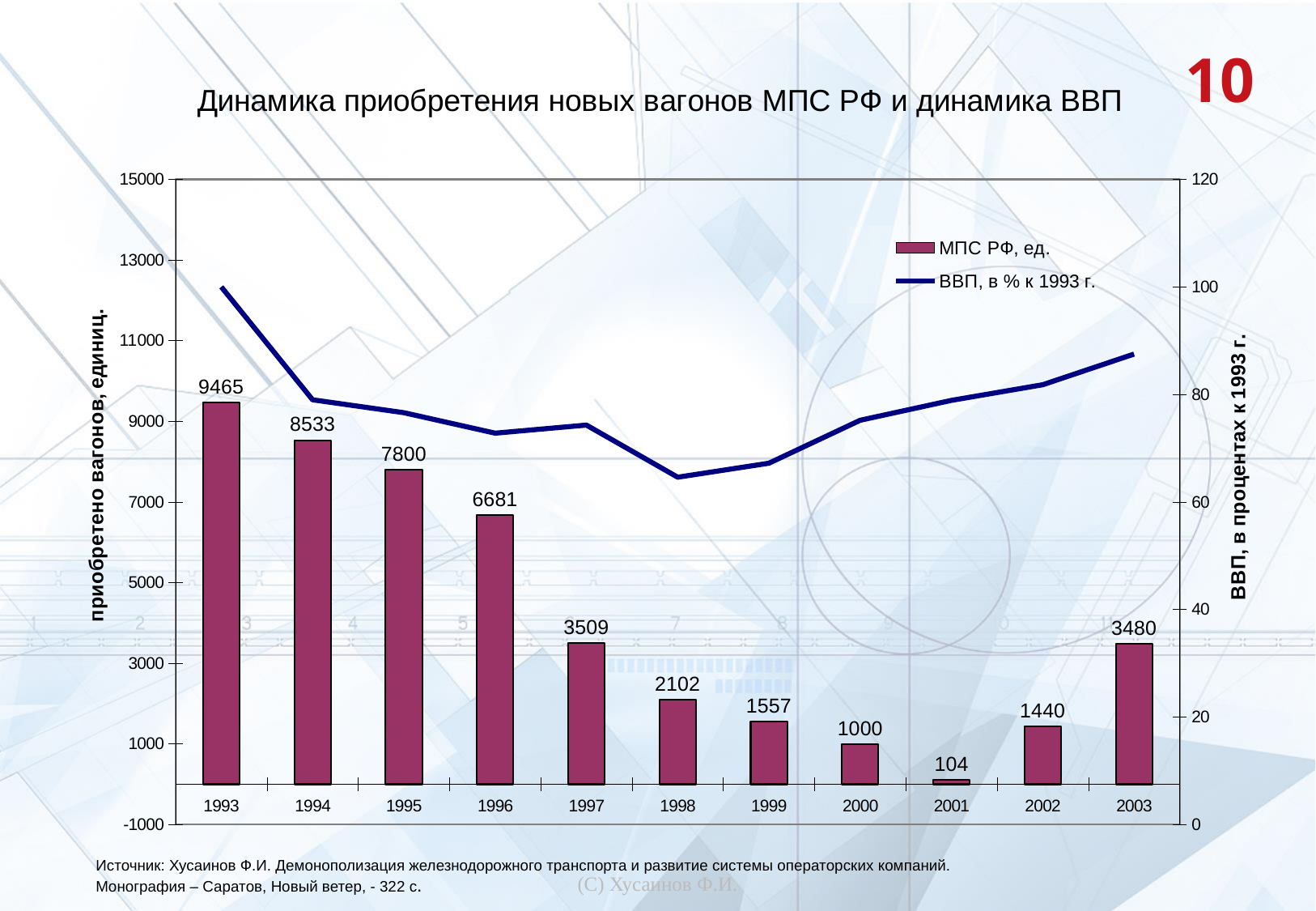
What is the difference between the МПС РФ, ед. values for 2003 and 2002? 2040 Which year has the highest value for МПС РФ, ед.? 1993 How many years are shown on the x axis of the chart? 11 How many new wagons did МПС РФ acquire in 1993 according to the chart? 9465 Which year has a larger МПС РФ, ед. value, 1997 or 2003? 1997 What is the value of the МПС РФ, ед. series for 2001? 104 Which year has the lowest value for МПС РФ, ед.? 2001 Is the value of ВВП, в % к 1993 г. for 1998 greater or less than 80? less What is the difference between the МПС РФ, ед. values for 1993 and 1994? 932 How many series does the chart legend list? 2 What is the value of the МПС РФ, ед. series for 2003? 3480 Is the value of ВВП, в % к 1993 г. for 2003 greater or less than 80? greater